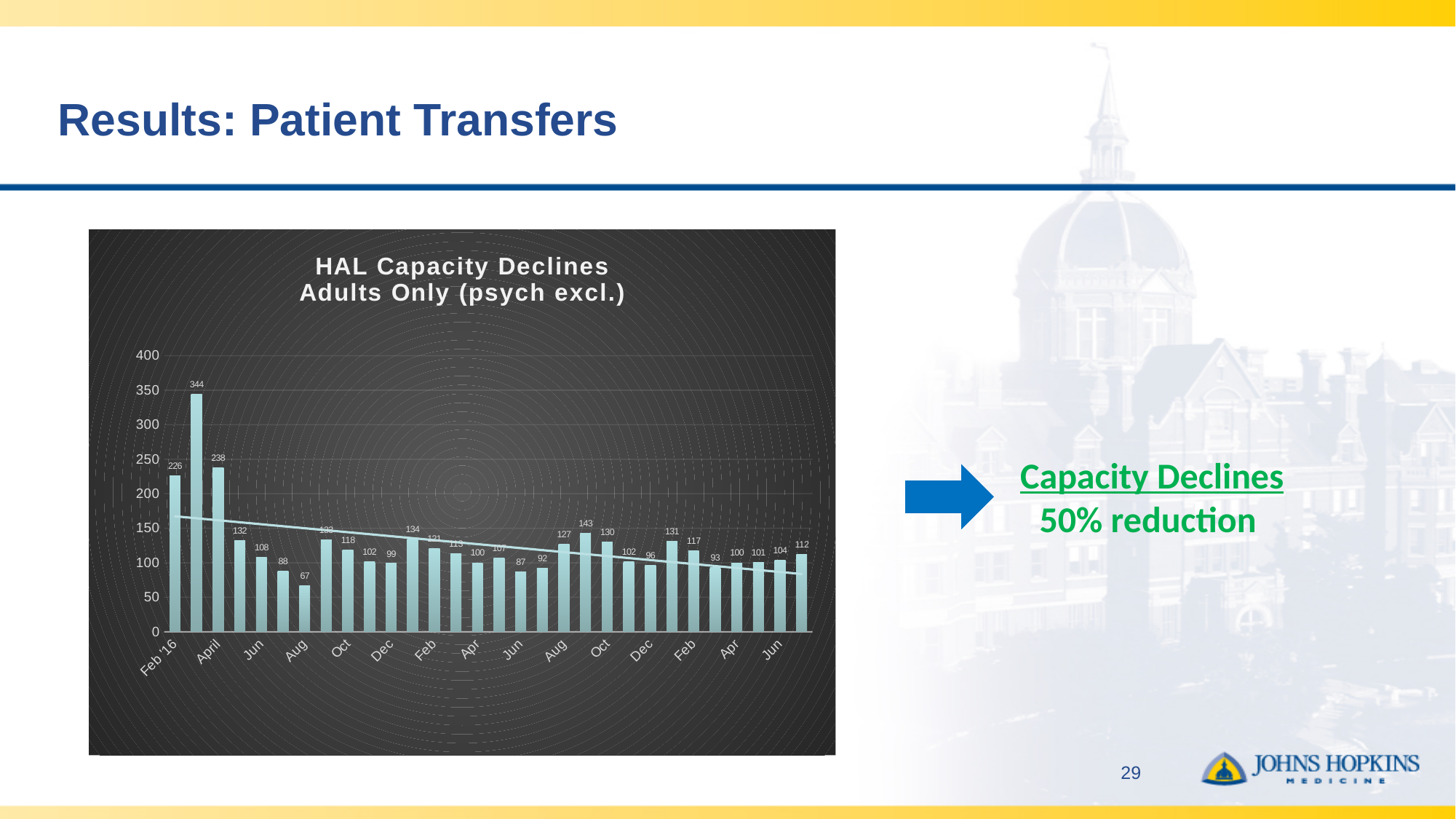
What is the title of the chart? HAL Capacity Declines Adults Only (psych excl.) Which is larger: the bar at Feb '16 or the bar at the first Aug label? Feb '16 What is the value of the bar at the first Aug label? 67 What is the difference between the highest bar (344) and the lowest bar (67)? 277 What is the lowest value shown on the chart? 67 How many bars are plotted on the chart? 30 What kind of chart is shown on the slide? bar chart What is the value of the bar labelled Feb '16? 226 Is the value of the bar at the first April label greater or less than 200? greater Do the values generally rise or fall from left to right along the x axis? fall What is the highest value shown on the chart? 344 What is the value of the bar at the first April label? 238